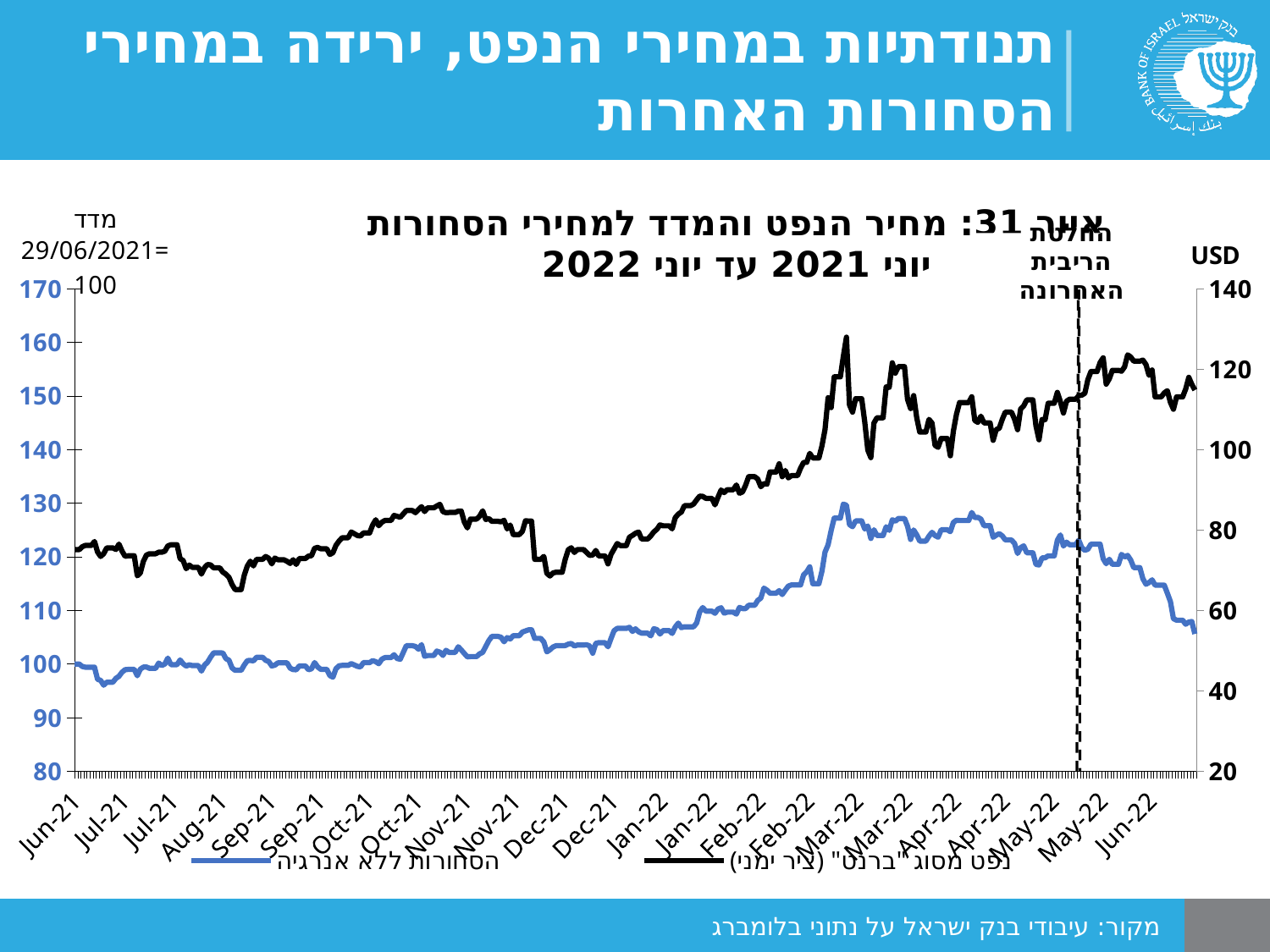
Is the value of the blue series (הסחורות ללא אנרגיה) at the end of the chart in Jun-22 greater or less than 100? greater Which series is plotted on the right axis (ציר ימני)? נפט מסוג "ברנט" Is the peak of the blue series (הסחורות ללא אנרגיה) around Mar-22 greater or less than 120? greater Is the peak of the black Brent oil series around Mar-22 greater or less than 120 USD? greater What is the unit shown on the right-hand axis? USD Does the black Brent oil series rise or fall overall from Jun-21 to Jun-22? rise How many series does the legend list? 2 What kind of chart is shown on the slide? line chart Does the blue series (הסחורות ללא אנרגיה) rise or fall between Mar-22 and Jun-22? fall Does the blue series (הסחורות ללא אנרגיה) rise or fall between Jun-21 and Mar-22? rise